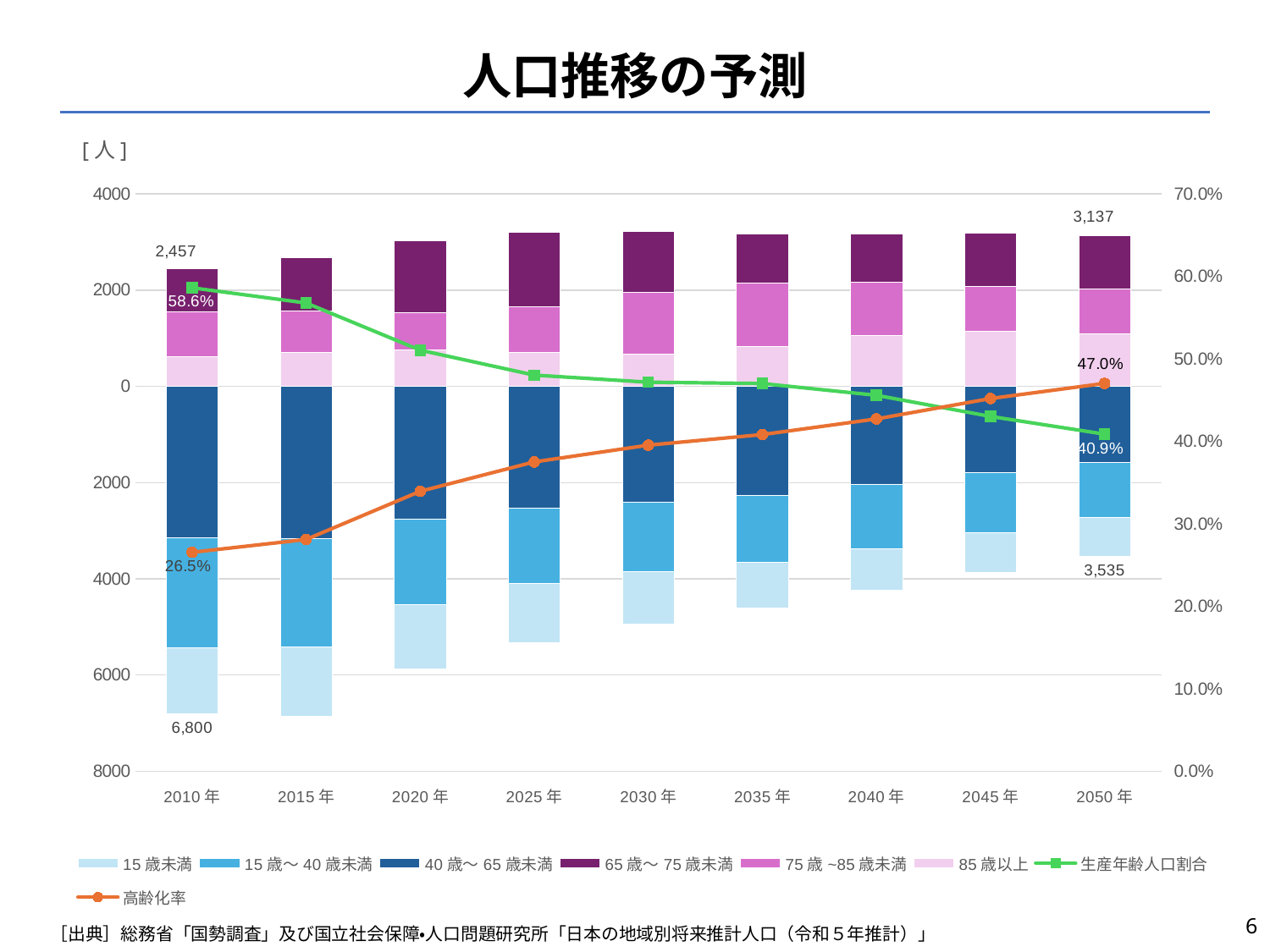
What is the 高齢化率 value shown for 2010年? 26.5% By how many percentage points does the 高齢化率 in 2050年 exceed that in 2010年? 20.5 What value is labelled at the bottom of the 2010年 bar? 6,800 Is the 高齢化率 value for 2020年 greater or less than 30.0%? greater Does the 高齢化率 line rise or fall from 2010年 to 2050年? rise What value is labelled at the bottom of the 2050年 bar? 3,535 What is the 生産年齢人口割合 value shown for 2050年? 40.9% How many years are shown on the x axis? 9 What is the 高齢化率 value shown for 2050年? 47.0% How many series does the legend list? 8 What value is labelled at the top of the 2010年 bar? 2,457 What is the 生産年齢人口割合 value shown for 2010年? 58.6%